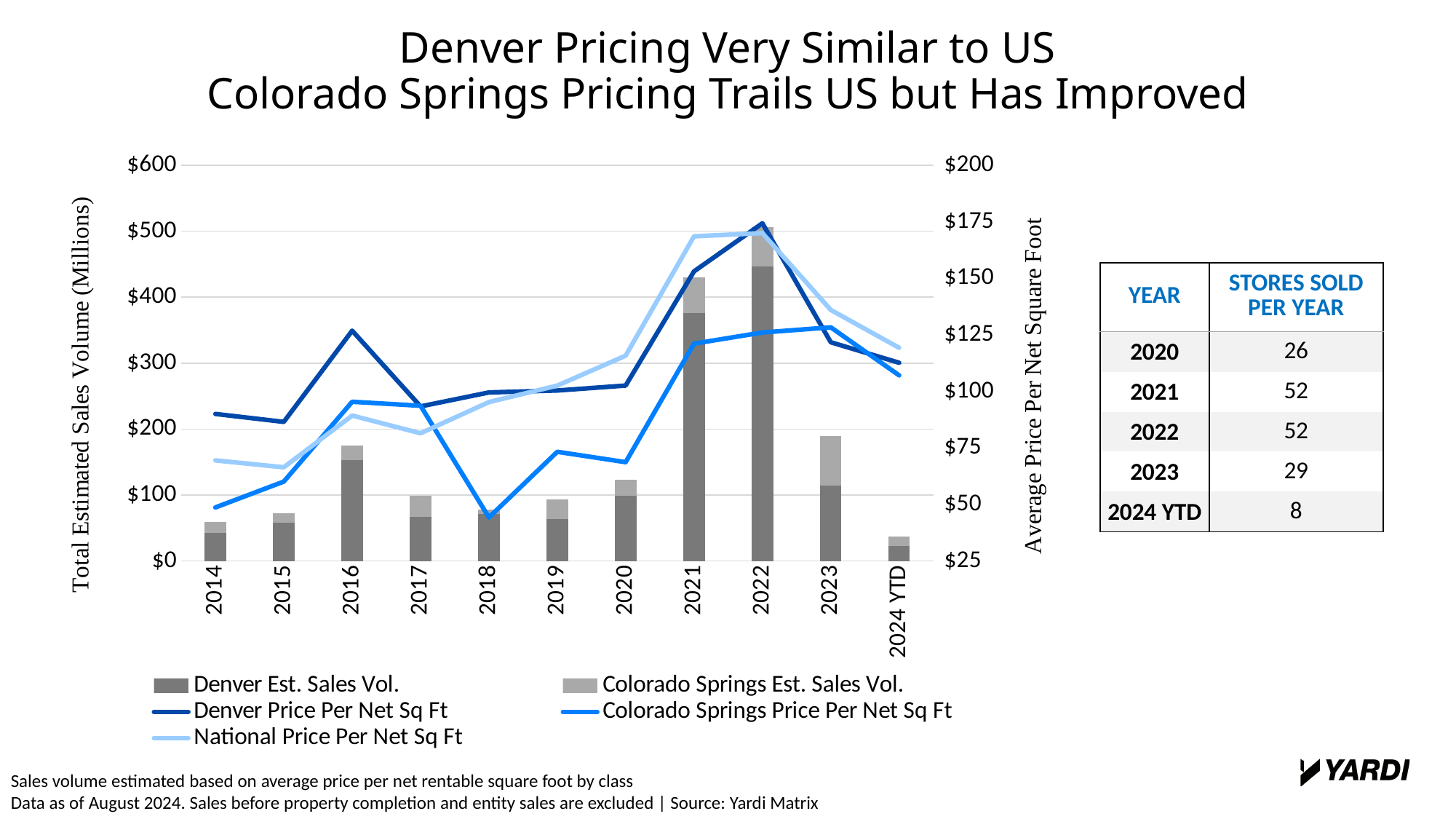
In which year is the total stacked sales volume bar the shortest? 2024 YTD In 2016, which is higher: the Denver Price Per Net Sq Ft or the Colorado Springs Price Per Net Sq Ft? Denver Price Per Net Sq Ft In which year is the total stacked sales volume bar the tallest? 2022 In which year does the Denver Price Per Net Sq Ft line reach its highest point? 2022 Is the Denver Est. Sales Vol. bar for 2022 greater or less than $400 million? greater Is the Colorado Springs Price Per Net Sq Ft value for 2018 greater or less than $50? less In which year does the Colorado Springs Price Per Net Sq Ft line reach its lowest point? 2018 Does the Denver Price Per Net Sq Ft line rise or fall from 2018 to 2022? rise How many series does the chart legend list? 5 How many years (categories) are shown on the x axis of the chart? 11 Is the Denver Price Per Net Sq Ft value for 2014 greater or less than $100? less What kind of chart is shown on the slide? A combination bar and line chart